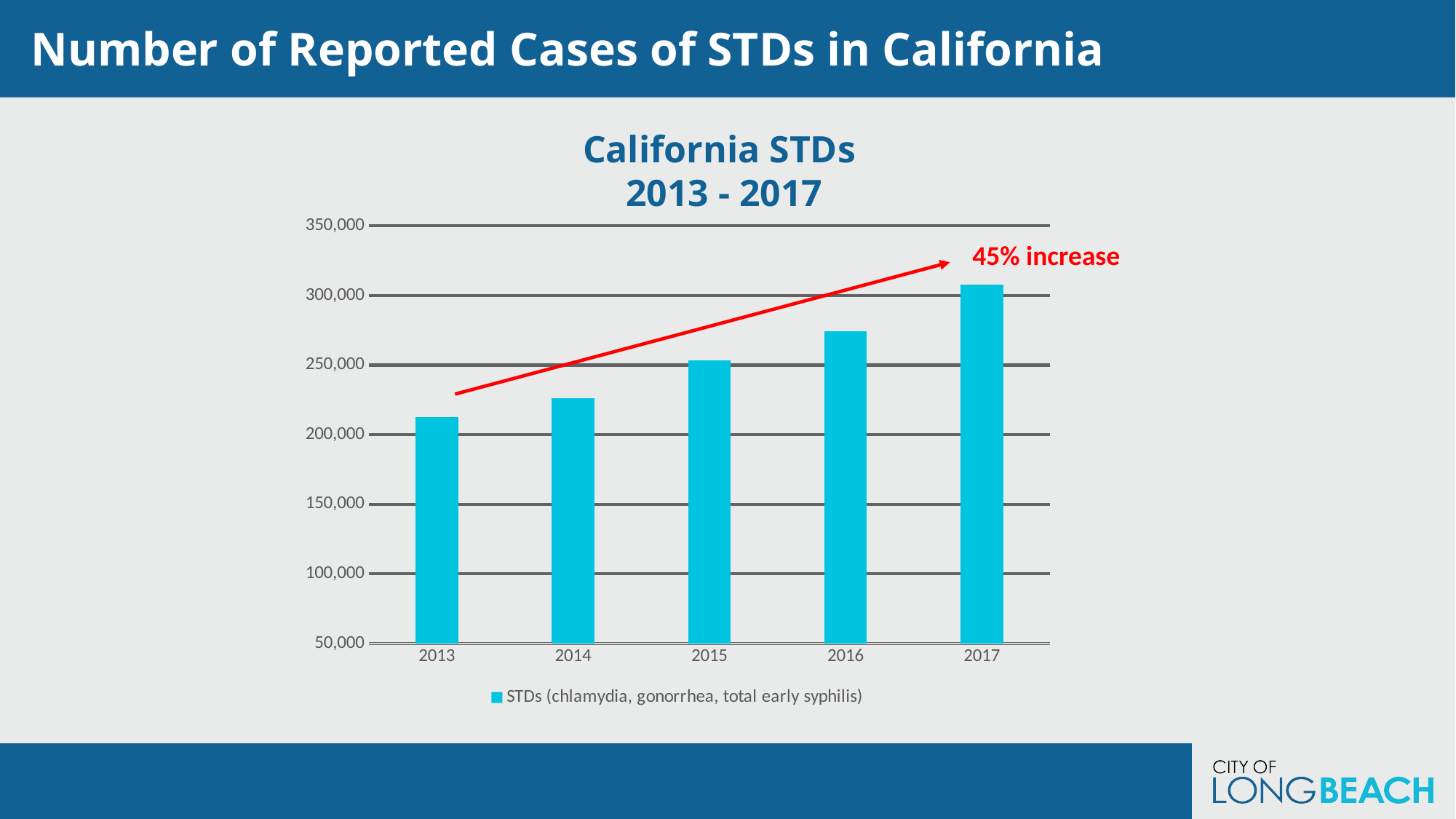
Which year has the lowest number of reported STD cases? 2013 Which year has more reported STD cases, 2014 or 2016? 2016 How many years are plotted on the chart? 5 What percentage increase does the red annotation on the chart state? 45% increase Is the value for 2014 greater or less than 250,000? less What is the title of the chart? California STDs 2013 - 2017 What kind of chart is shown on the slide? bar chart Is the value for 2013 greater or less than 200,000? greater How many series does the legend list? 1 Do the reported STD cases rise or fall from 2013 to 2017? rise Which year has the highest number of reported STD cases? 2017 Is the value for 2016 greater or less than 300,000? less